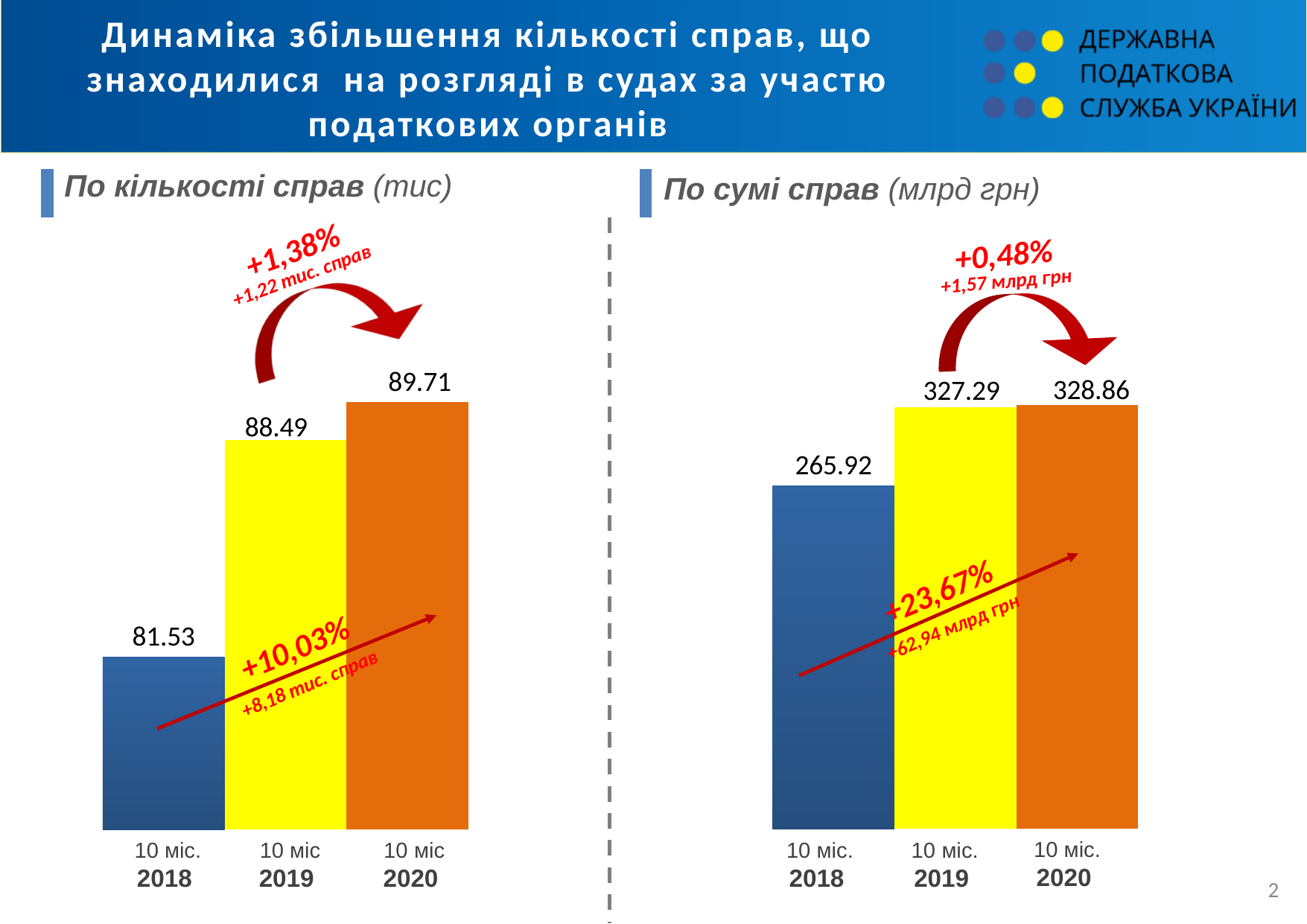
In the left chart 'По кількості справ (тис)', which is larger: the value for 10 міс. 2019 or 10 міс. 2018? 10 міс. 2019 In the right chart 'По сумі справ (млрд грн)', what is the value for 10 міс. 2019? 327.29 In the left chart 'По кількості справ (тис)', what is the difference between the values for 10 міс. 2020 and 10 міс. 2018? 8.18 In the left chart 'По кількості справ (тис)', which period has the lowest value? 10 міс. 2018 In the right chart 'По сумі справ (млрд грн)', which period has the highest value? 10 міс. 2020 In the right chart 'По сумі справ (млрд грн)', do the values rise or fall from 2018 to 2020? rise In the right chart 'По сумі справ (млрд грн)', what is the value for 10 міс. 2018? 265.92 What kind of chart is the left chart 'По кількості справ (тис)'? bar chart In the left chart 'По кількості справ (тис)', what is the value for 10 міс. 2020? 89.71 How many bars does the right chart 'По сумі справ (млрд грн)' have? 3 In the right chart 'По сумі справ (млрд грн)', what is the difference between the values for 10 міс. 2019 and 10 міс. 2018? 61.37 In the left chart 'По кількості справ (тис)', what is the value for 10 міс. 2018? 81.53